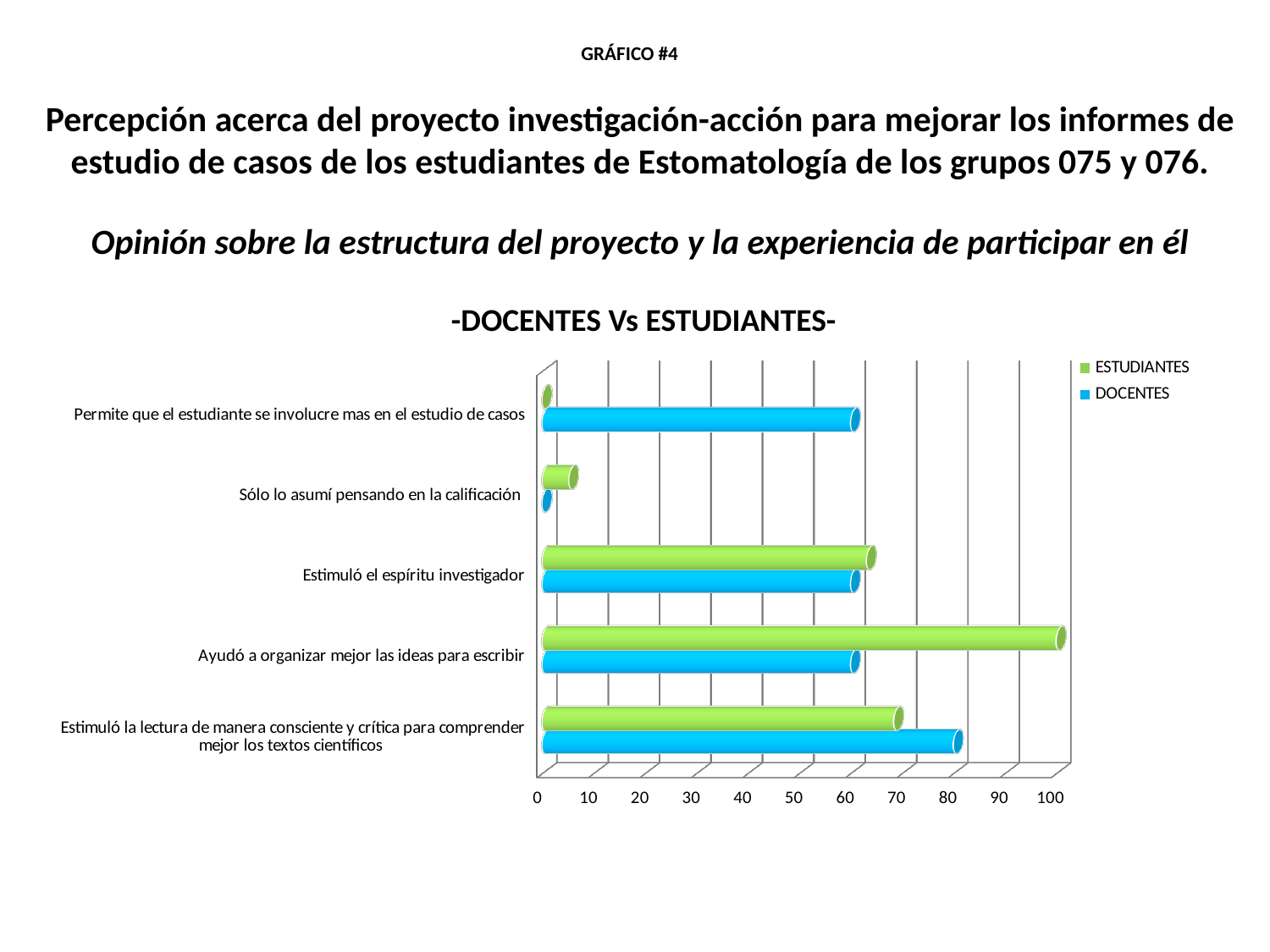
How many series does the legend list? 2 Which category has the lowest value for DOCENTES? Sólo lo asumí pensando en la calificación Is the ESTUDIANTES value for 'Ayudó a organizar mejor las ideas para escribir' greater or less than 90? greater For 'Ayudó a organizar mejor las ideas para escribir', which series has the larger value, DOCENTES or ESTUDIANTES? ESTUDIANTES Is the ESTUDIANTES value for 'Permite que el estudiante se involucre mas en el estudio de casos' greater or less than 10? less Which category has the highest value for DOCENTES? Estimuló la lectura de manera consciente y crítica para comprender mejor los textos científicos Which colour represents the DOCENTES series in the legend? blue What kind of chart is shown on the slide? bar chart For 'Estimuló la lectura de manera consciente y crítica para comprender mejor los textos científicos', which series has the larger value, DOCENTES or ESTUDIANTES? DOCENTES Is the DOCENTES value for 'Estimuló la lectura de manera consciente y crítica para comprender mejor los textos científicos' greater or less than 70? greater Which category has the highest value for ESTUDIANTES? Ayudó a organizar mejor las ideas para escribir How many categories are shown on the chart? 5